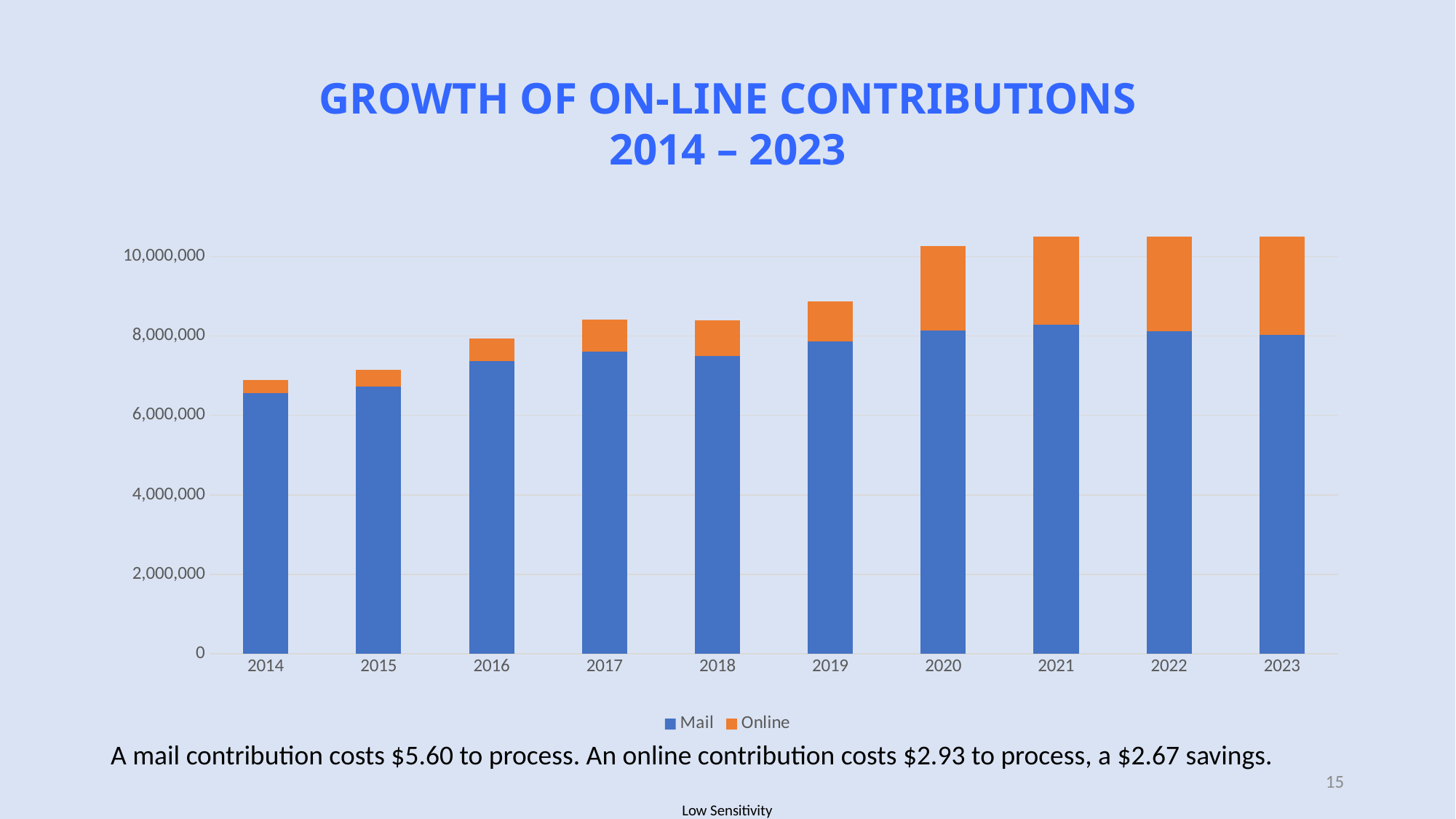
How many years are shown on the x axis of the chart? 10 Which year has the smallest Online segment? 2014 Is the total bar for 2014 greater or less than 8,000,000? less Which year has the lowest total contributions (Mail plus Online)? 2014 What are the two series named in the legend? Mail and Online How many series does the chart's legend list? 2 What is the title of the chart on the slide? GROWTH OF ON-LINE CONTRIBUTIONS 2014 – 2023 Do the total contributions generally rise or fall from 2014 to 2023? rise Is the Mail value for 2017 greater or less than 8,000,000? less Which is larger, the total bar for 2014 or the total bar for 2020? 2020 What kind of chart is shown on the slide? Stacked bar chart Is the total bar for 2020 greater or less than 10,000,000? greater